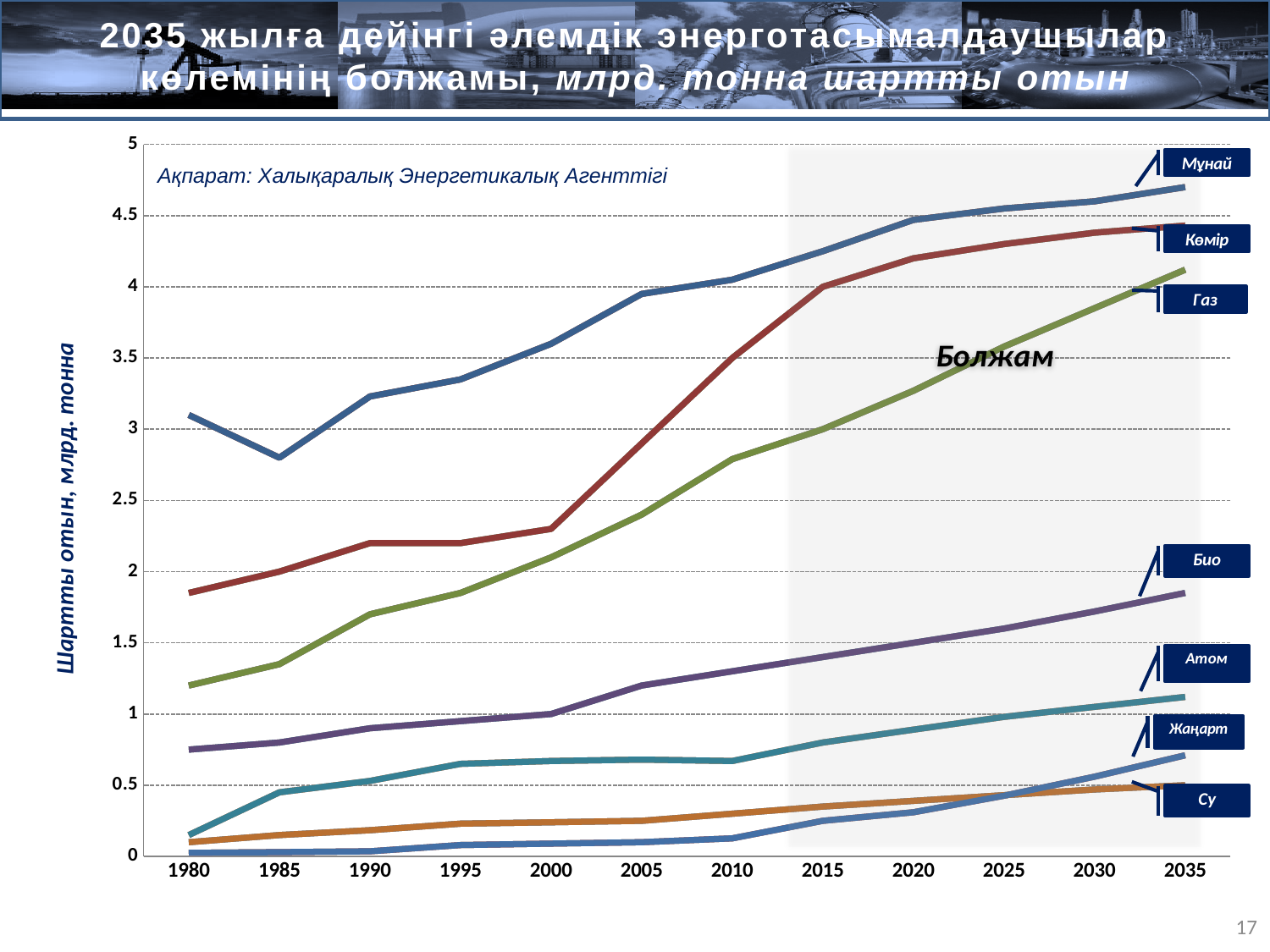
Does the Газ series rise or fall from 1980 to 2035? rises Is the value for Био in 2035 greater or less than 1.5? greater In 2035, which is larger: Көмір or Газ? Көмір How many series are labelled on the chart? 7 Which series has the highest value in 2035? Мұнай Is the value for Көмір in 1980 greater or less than 2? less Which series has the lowest value in 2035? Су Is the value for Мұнай in 2035 greater or less than 4.5? greater What kind of chart is shown on the slide? line chart How many years are marked along the x axis of the chart? 12 What is the label of the shaded region on the right side of the chart? Болжам In 2035, which is larger: Жаңарт or Су? Жаңарт